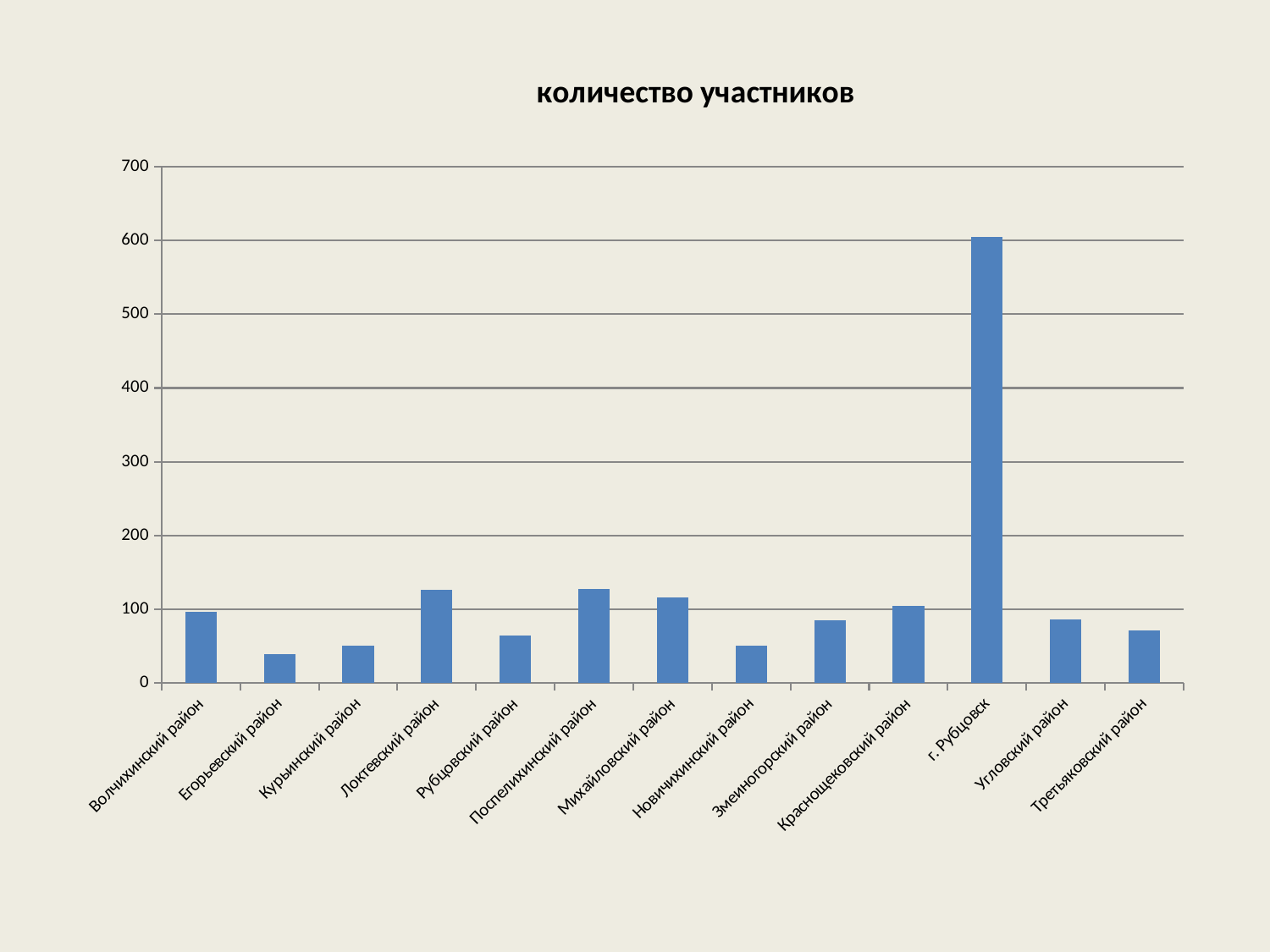
Is the value for Краснощековский район greater or less than 200? less Is the value for Локтевский район greater or less than 100? greater How many categories are shown on the x axis of the chart? 13 Which category has the highest value in the chart? г. Рубцовск Which is larger, the value for Поспелихинский район or the value for Рубцовский район? Поспелихинский район What type of chart is shown on the slide? bar chart What is the title of the chart? количество участников What is the highest value shown on the y axis of the chart? 700 Which is larger, the value for г. Рубцовск or the value for Волчихинский район? г. Рубцовск Is the value for Егорьевский район greater or less than 100? less Which category has the lowest value in the chart? Егорьевский район